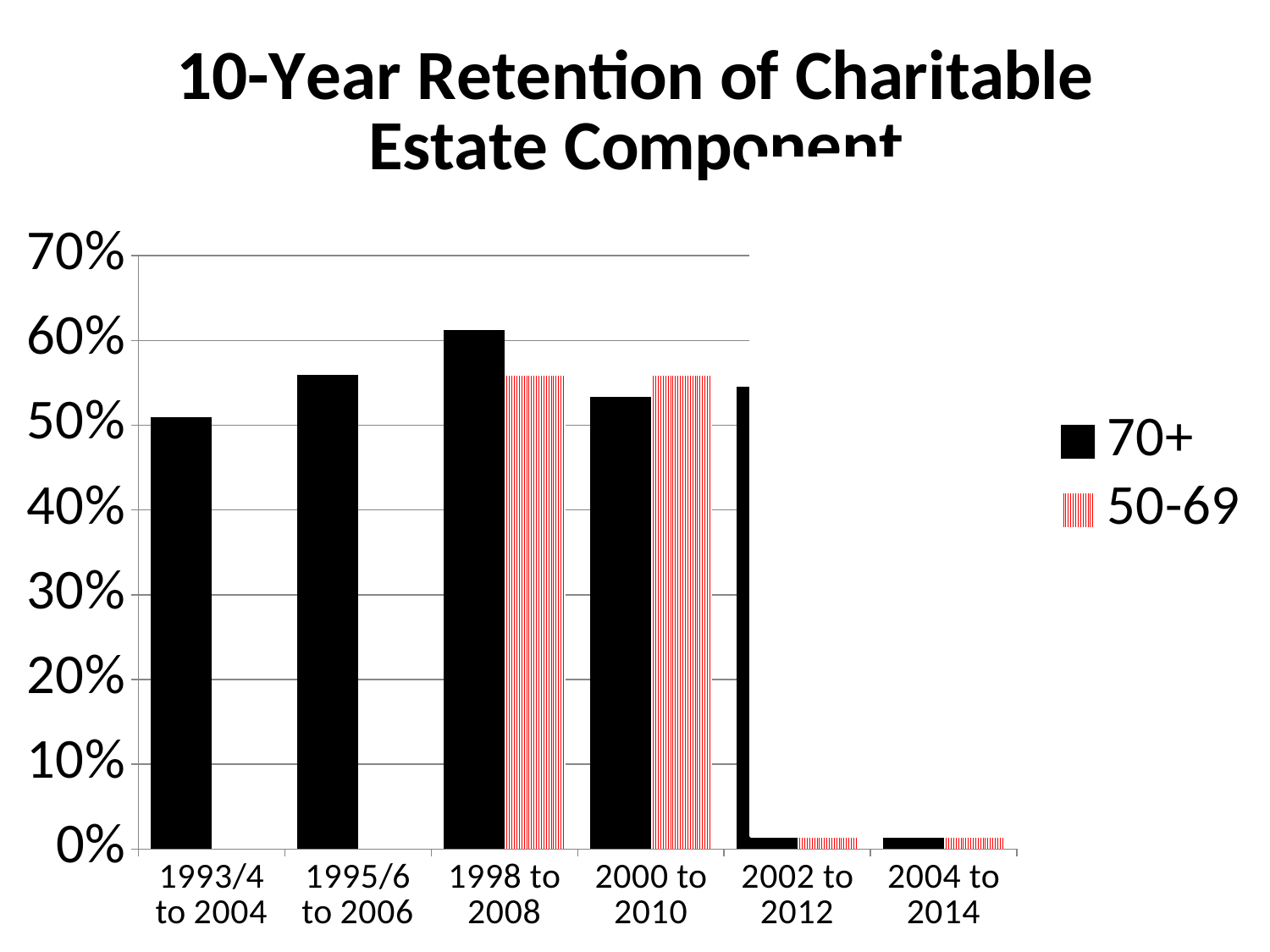
Which category has the lowest value for the 70+ series? 2004 to 2014 For 1998 to 2008, which series has the larger value, 70+ or 50-69? 70+ For 2000 to 2010, which series has the larger value, 70+ or 50-69? 50-69 How many series does the legend list? 2 Which category has the highest value for the 70+ series? 1998 to 2008 How many time-period categories are shown on the x axis? 6 Is the 70+ value for 1998 to 2008 greater or less than 50%? greater Is the 50-69 value for 2004 to 2014 greater or less than 10%? less Is the 70+ value for 1993/4 to 2004 greater or less than 60%? less What are the two series named in the legend? 70+ and 50-69 For the 70+ series, which is larger: 1993/4 to 2004 or 1995/6 to 2006? 1995/6 to 2006 What kind of chart is shown on the slide? bar chart